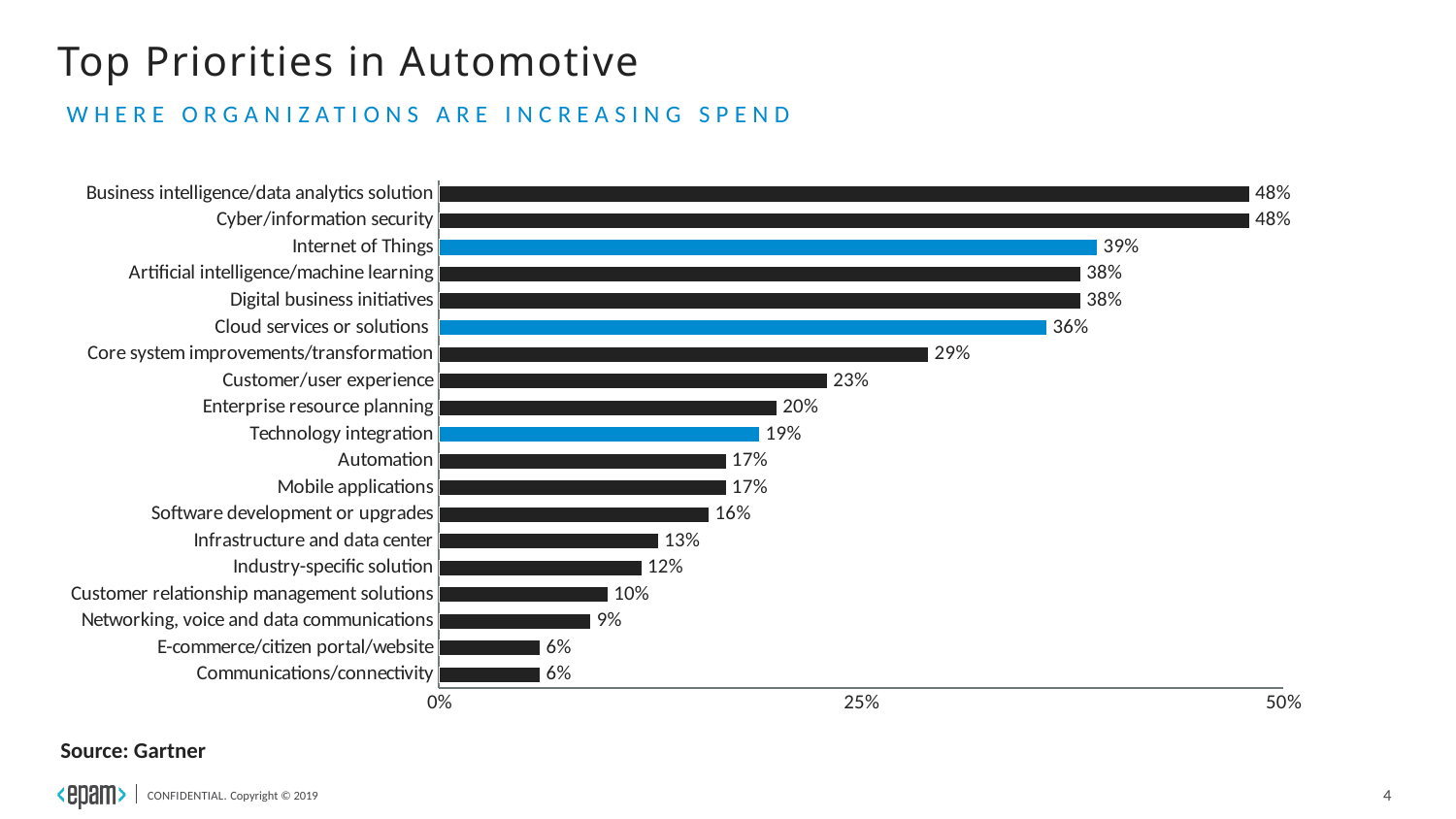
What kind of chart is shown on the slide? bar chart What is the value for Core system improvements/transformation? 29% What is the difference between the values for Internet of Things and Cloud services or solutions? 3% How many categories are shown on the chart? 19 Is the value for Core system improvements/transformation greater or less than 25%? greater What is the value for Cloud services or solutions? 36% What is the source cited for the chart? Gartner What is the lowest value shown on the chart? 6% Which has a larger value, Customer/user experience or Enterprise resource planning? Customer/user experience What is the value for Technology integration? 19% What is the highest value shown on the chart? 48% What percentage of organizations are increasing spend on Internet of Things? 39%